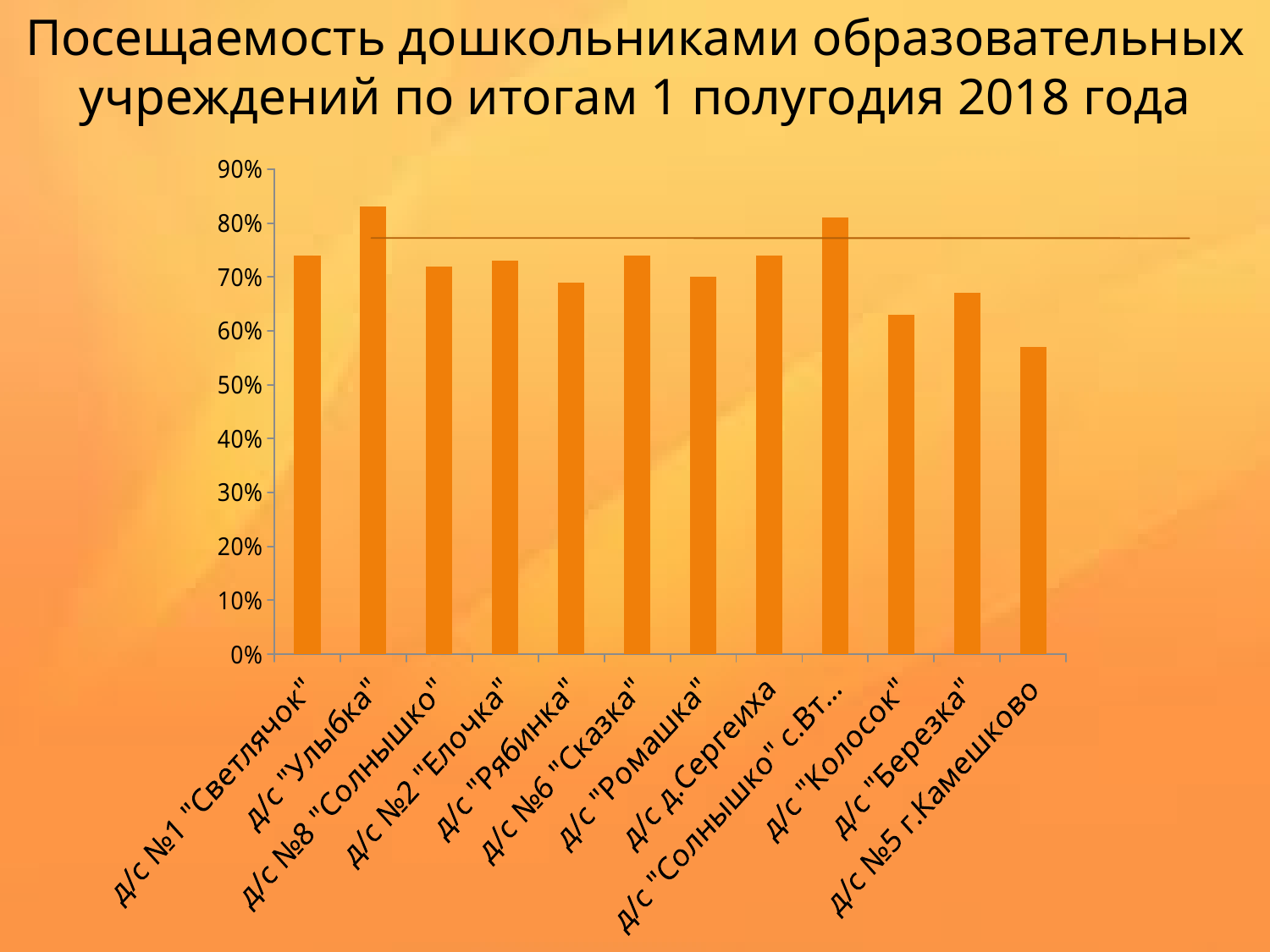
Which has the higher attendance: д/с "Улыбка" or д/с "Колосок"? д/с "Улыбка" Is the value for д/с "Березка" greater or less than 70%? less How many kindergartens (bars) are shown in the chart? 12 Which kindergarten has the highest attendance in the chart? д/с "Улыбка" Which has the lower attendance: д/с "Березка" or д/с №5 г.Камешково? д/с №5 г.Камешково What is the highest value shown on the vertical axis of the chart? 90% What kind of chart is shown on the slide? bar chart Is the value for д/с "Колосок" greater or less than 60%? greater Which kindergarten has the lowest attendance in the chart? д/с №5 г.Камешково Is the value for д/с "Улыбка" greater or less than 80%? greater